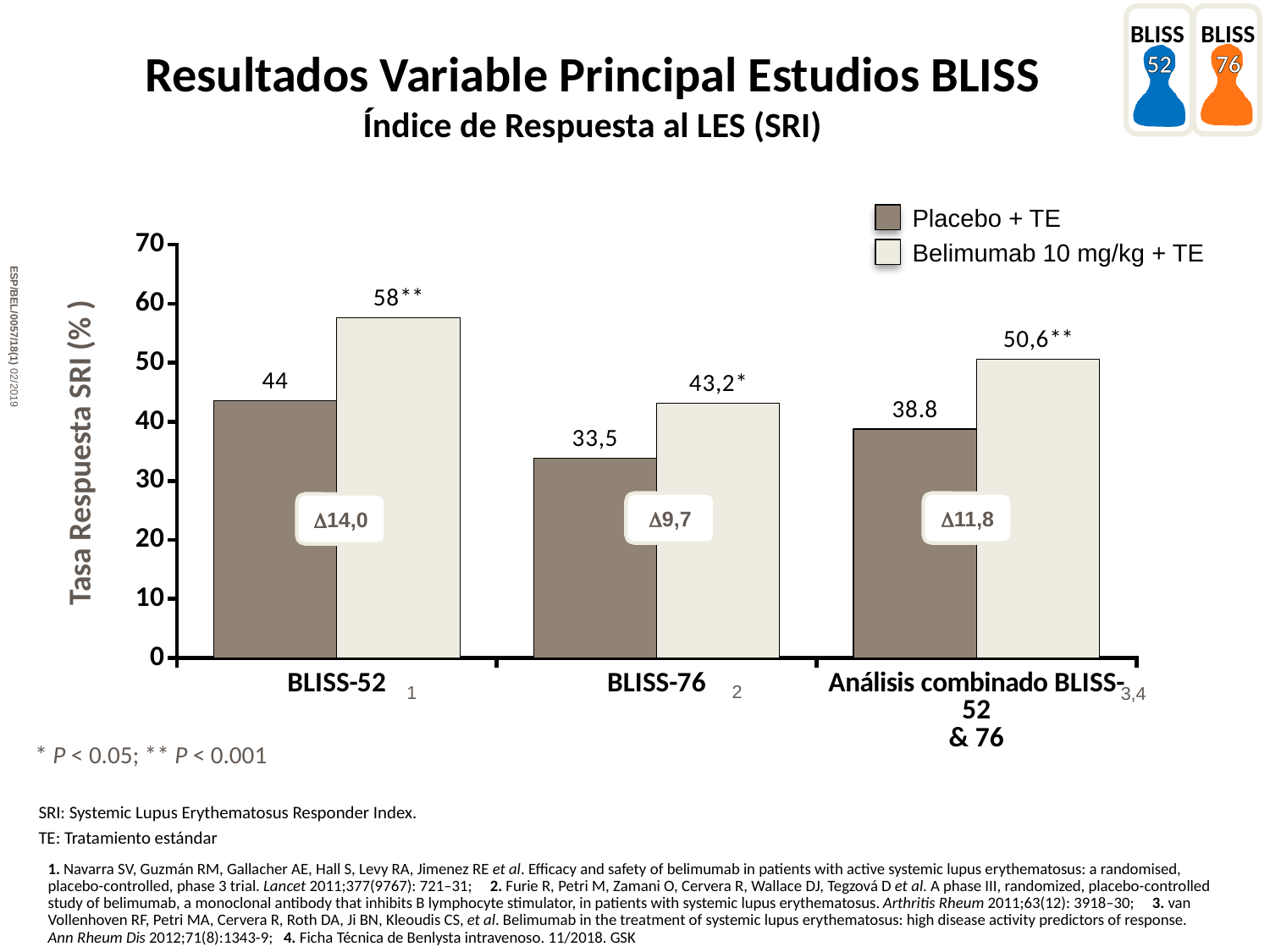
What is the difference between the Belimumab 10 mg/kg + TE and Placebo + TE response rates in the Análisis combinado BLISS-52 & 76? 11,8 How many series does the legend list? 2 What is the difference between the Belimumab 10 mg/kg + TE and Placebo + TE response rates in BLISS-76? 9,7 Which is larger in BLISS-52: the Placebo + TE rate or the Belimumab 10 mg/kg + TE rate? Belimumab 10 mg/kg + TE What is the SRI response rate for Belimumab 10 mg/kg + TE in BLISS-76? 43,2 What kind of chart is shown on the slide? Bar chart What is the SRI response rate for Belimumab 10 mg/kg + TE in BLISS-52? 58 How many study groups (categories) are shown on the x axis? 3 What is the SRI response rate for Placebo + TE in BLISS-52? 44 What is the SRI response rate for Placebo + TE in the Análisis combinado BLISS-52 & 76? 38.8 Which study group has the highest Belimumab 10 mg/kg + TE response rate? BLISS-52 Which study group has the lowest Placebo + TE response rate? BLISS-76